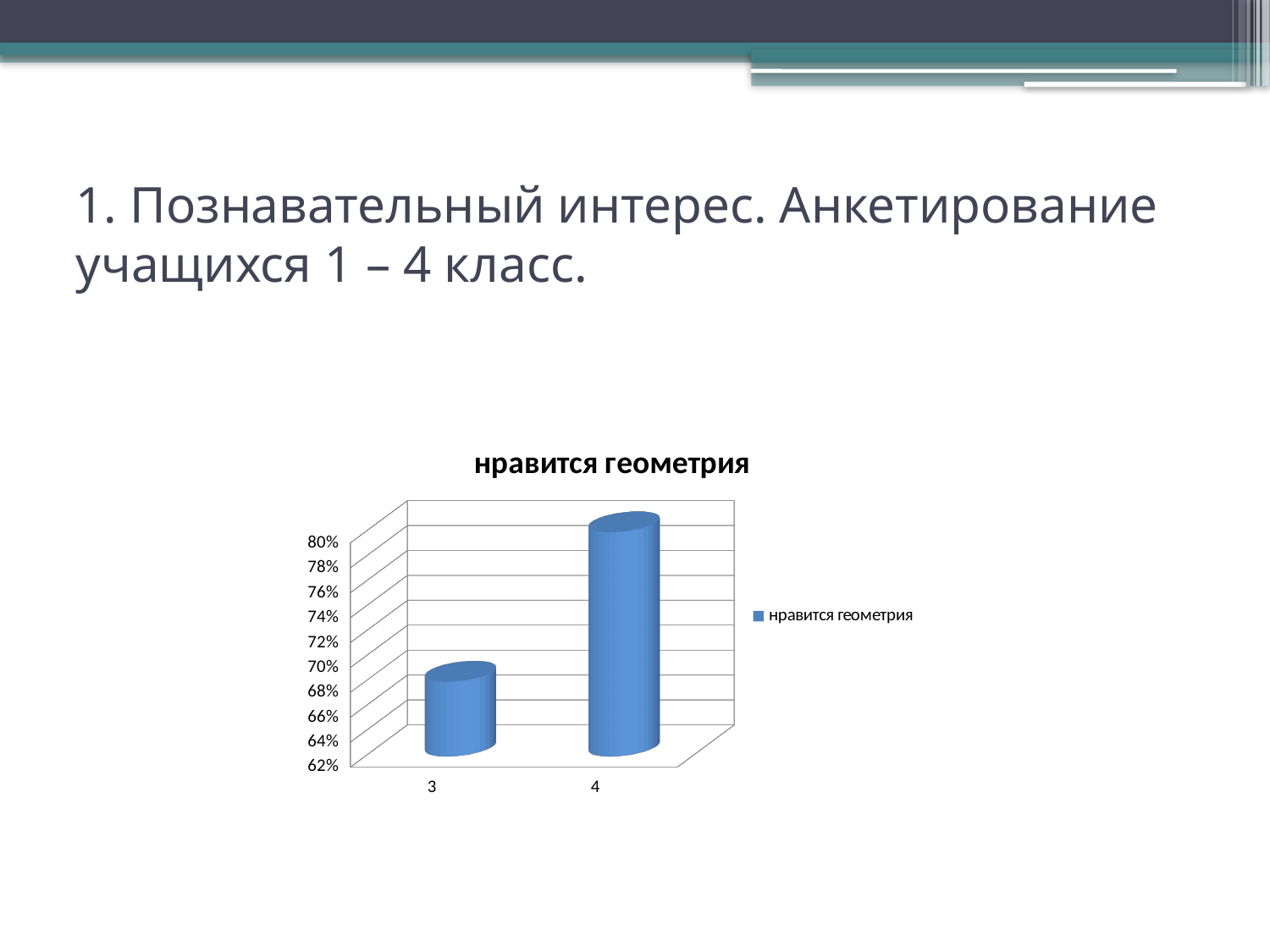
What kind of chart is shown on the slide? bar chart Is the value for category 3 greater or less than 64%? greater Which category has the highest value in the chart? 4 What is the name of the series listed in the legend? нравится геометрия How many series does the chart legend list? 1 Which is larger, the value for category 3 or the value for category 4? 4 Which category has the lowest value in the chart? 3 What is the title of the chart? нравится геометрия Is the value for category 3 greater or less than 74%? less Is the value for category 4 greater or less than 74%? greater How many categories are shown on the x axis of the chart? 2 Do the values rise or fall from category 3 to category 4? rise